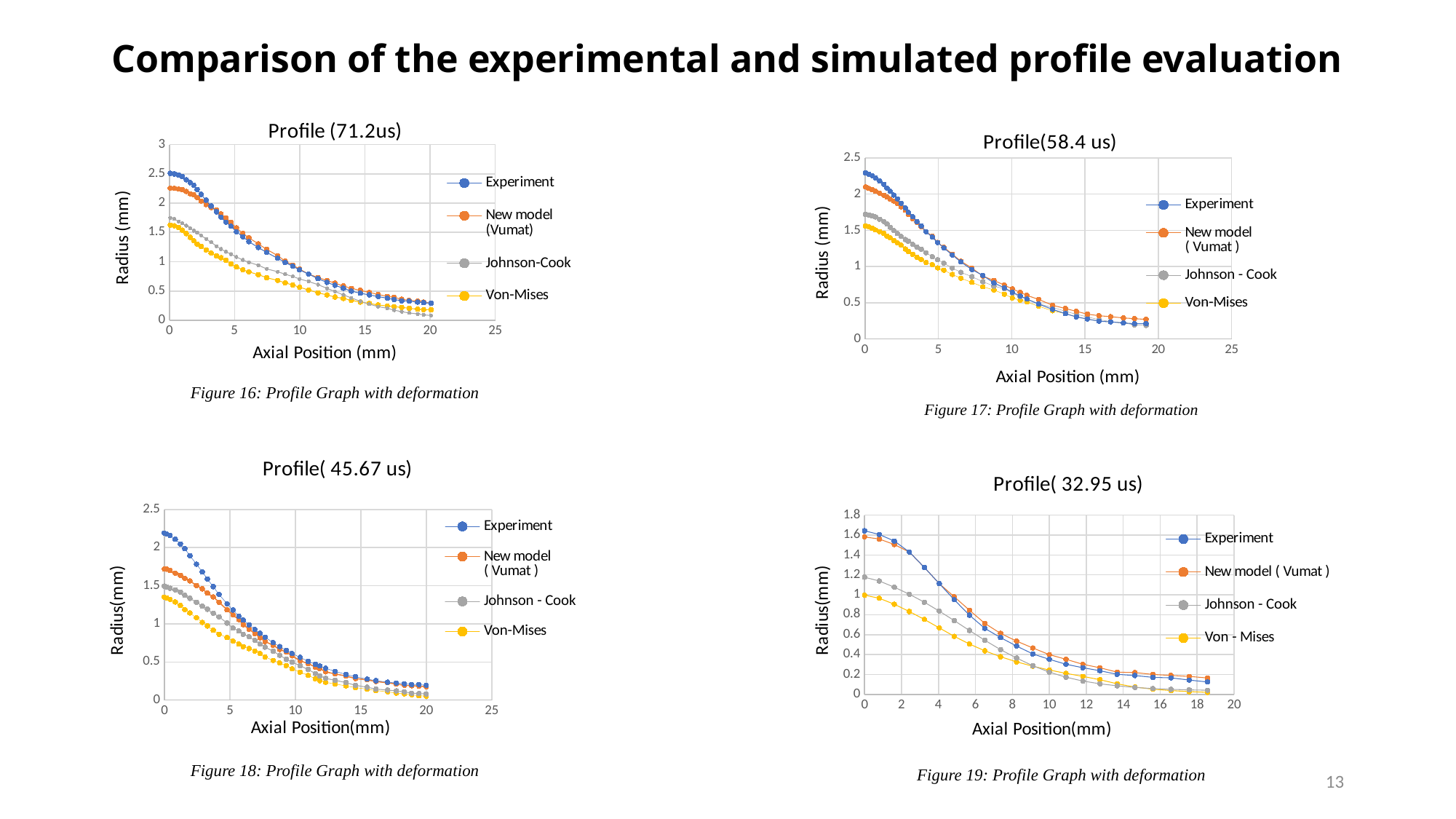
In the "Profile(58.4 us)" chart, is the Von-Mises radius at axial position 0 greater or less than 2? less In the "Profile (71.2us)" chart, is the Experiment radius at axial position 0 greater or less than 2? greater In the "Profile( 32.95 us)" chart, is the Johnson - Cook radius at axial position 0 greater or less than 1? greater In the "Profile( 32.95 us)" chart, which series has the larger radius at axial position 0, Johnson - Cook or Von - Mises? Johnson - Cook In the "Profile (71.2us)" chart, does the Experiment radius rise or fall as axial position increases? fall What kind of chart is the "Profile (71.2us)" chart? line chart In the "Profile( 45.67 us)" chart, which series has the lowest radius at axial position 0? Von-Mises How many series does the legend of the "Profile (71.2us)" chart list? 4 What is the x-axis label of the "Profile( 32.95 us)" chart? Axial Position(mm) What is the figure caption below the "Profile (71.2us)" chart? Figure 16: Profile Graph with deformation In the "Profile(58.4 us)" chart, which series has the larger radius at axial position 0, Experiment or Johnson - Cook? Experiment